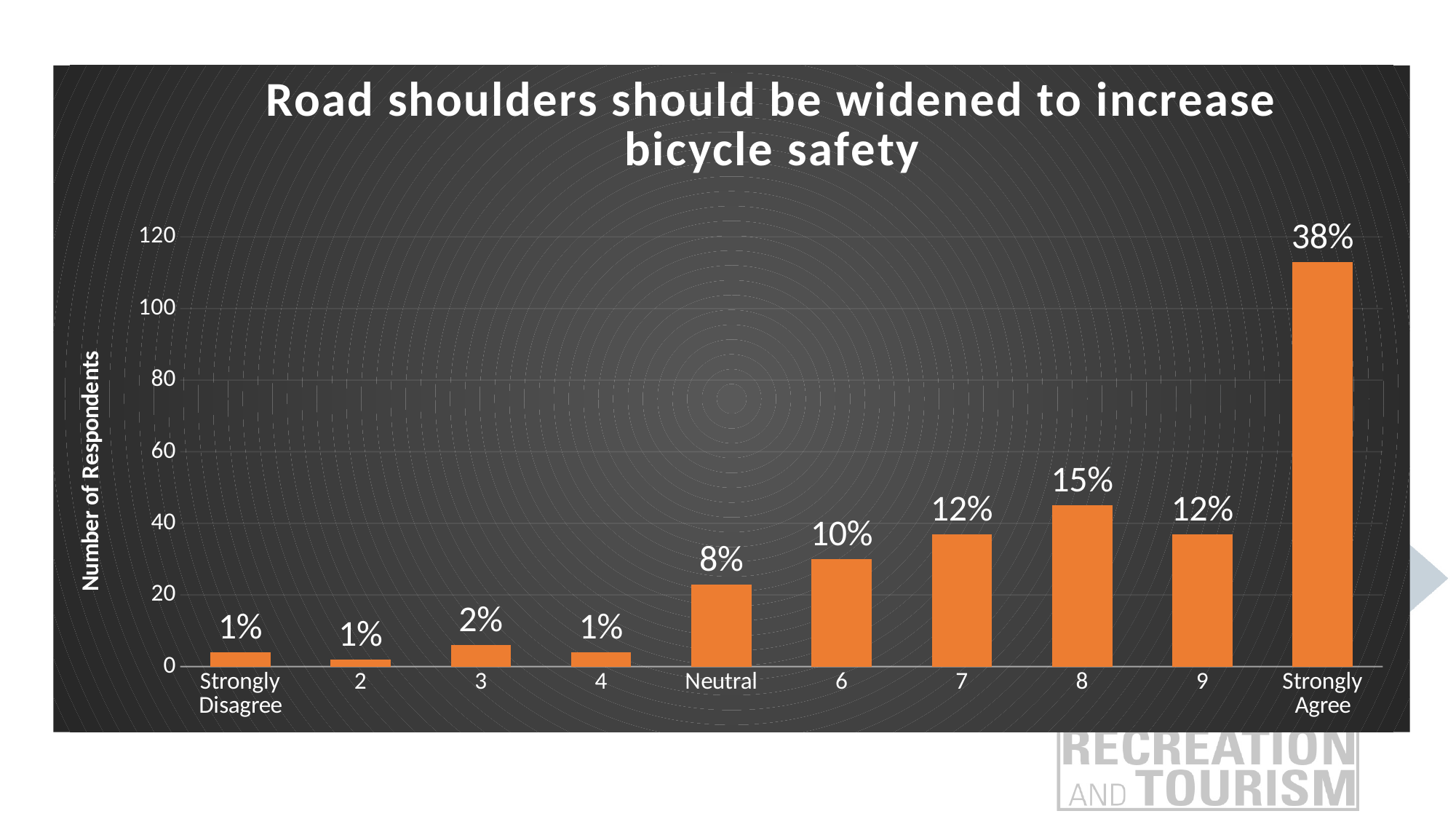
Is the number of respondents for Neutral greater or less than 40? less Which category has the highest bar? Strongly Agree What is the title of the vertical axis? Number of Respondents What kind of chart is shown on the slide? Bar chart How many categories are shown on the x axis? 10 What is the data label shown for category 8? 15% What is the data label shown for category 3? 2% What is the data label shown for the Neutral bar? 8% What is the difference between the percentage labels for Strongly Agree and category 8? 23% Is the number of respondents for Strongly Agree greater or less than 100? greater What is the data label shown for the Strongly Agree bar? 38% Which has a larger value, category 8 or category 9? 8